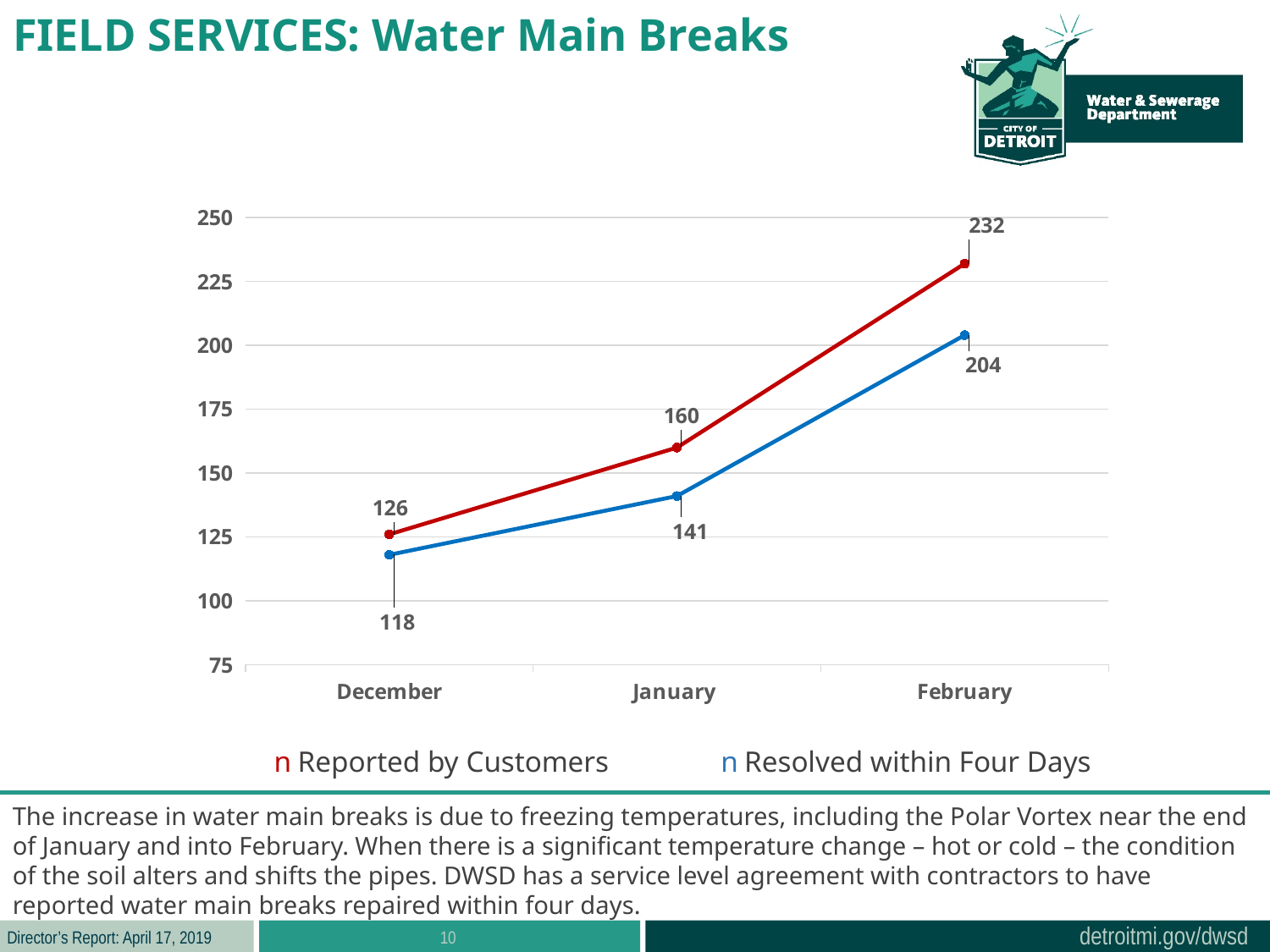
What kind of chart is shown on the slide? line chart In which month is Reported by Customers highest? February Which is larger in January: Reported by Customers or Resolved within Four Days? Reported by Customers How many months are plotted on the x axis? 3 What is the value for Reported by Customers in December? 126 How many series does the legend list? 2 What is the value for Reported by Customers in February? 232 Which colour is the Reported by Customers line? red Do the Resolved within Four Days values rise or fall from December to February? rise What is the difference between Reported by Customers and Resolved within Four Days in February? 28 What is the value for Resolved within Four Days in January? 141 In which month is Resolved within Four Days lowest? December